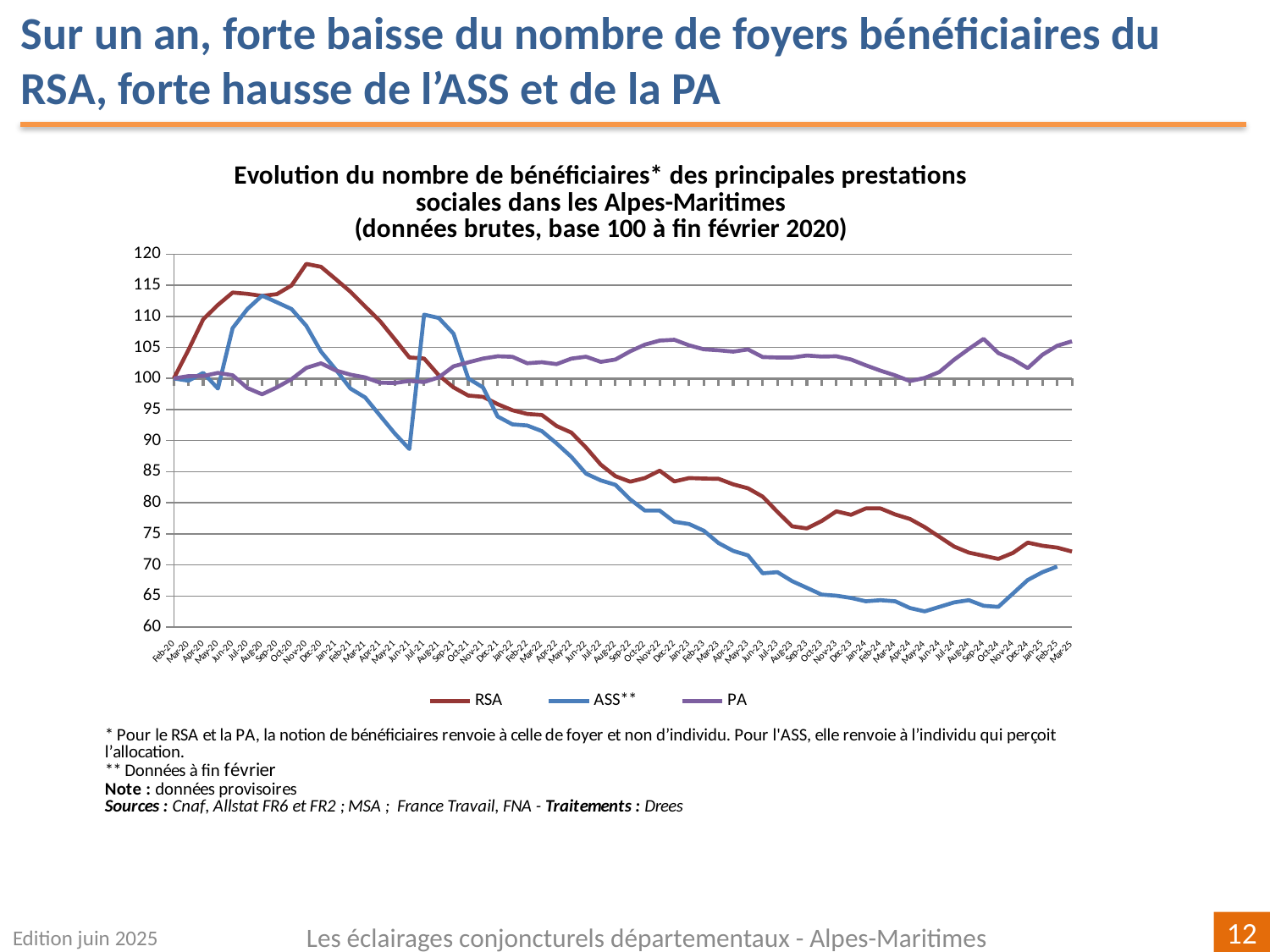
Which series has the lowest value at Mar-25? RSA Which series reaches the highest value on the chart? RSA Which series are listed in the legend? RSA, ASS**, PA Does the ASS** series rise or fall overall between Feb-20 and Mar-25? fall Is the value for RSA at Mar-25 greater or less than 75? less At Mar-25, which series is higher, PA or RSA? PA Is the value for PA at Mar-25 greater or less than 100? greater What is the base value of the index, and at which date, according to the chart title? base 100 à fin février 2020 What kind of chart is shown on the slide? line chart Is the peak value of RSA in late 2020 greater or less than 115? greater Does the RSA series rise or fall overall between Feb-20 and Mar-25? fall How many series does the legend list? 3